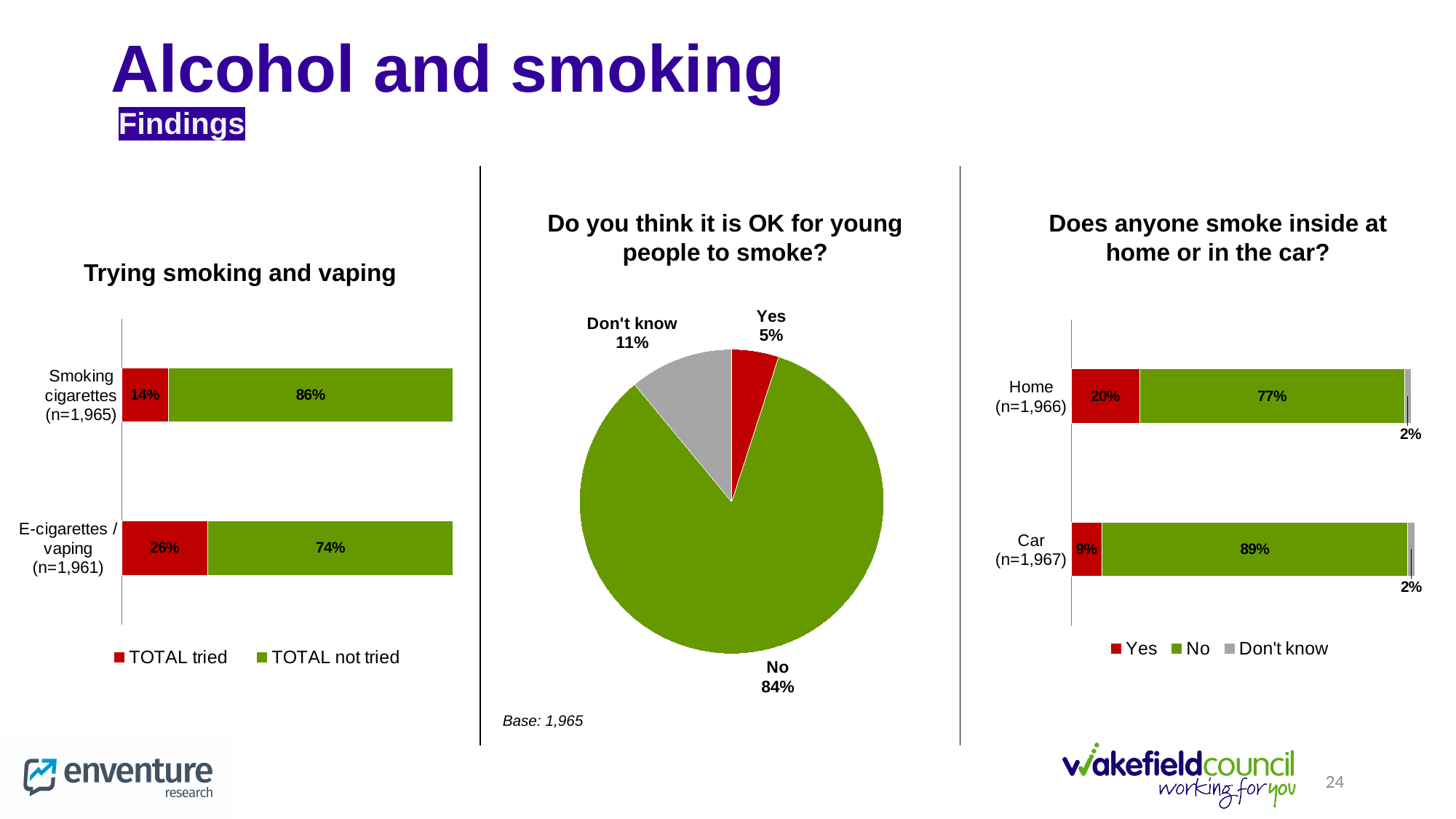
In the 'Do you think it is OK for young people to smoke?' pie chart, what share of respondents answered 'Don't know'? 11% In the 'Do you think it is OK for young people to smoke?' pie chart, which response has the smallest slice? Yes In the 'Trying smoking and vaping' chart, what percentage have not tried e-cigarettes / vaping? 74% In the 'Trying smoking and vaping' chart, which category has the higher 'TOTAL tried' value: smoking cigarettes or e-cigarettes / vaping? E-cigarettes / vaping In the 'Trying smoking and vaping' chart, how many series does the legend list? 2 In the 'Does anyone smoke inside at home or in the car?' chart, what percentage answered 'No' for Car? 89% In the 'Trying smoking and vaping' chart, what is the difference between the 'TOTAL tried' values for e-cigarettes / vaping and smoking cigarettes? 12 percentage points What kind of chart is 'Do you think it is OK for young people to smoke?'? Pie chart In the 'Do you think it is OK for young people to smoke?' pie chart, what is the base shown below the chart? 1,965 In the 'Does anyone smoke inside at home or in the car?' chart, what percentage answered 'Yes' for Home? 20% In the 'Does anyone smoke inside at home or in the car?' chart, what is the difference between the 'Yes' values for Home and Car? 11 percentage points In the 'Trying smoking and vaping' chart, what percentage of respondents have tried smoking cigarettes? 14%